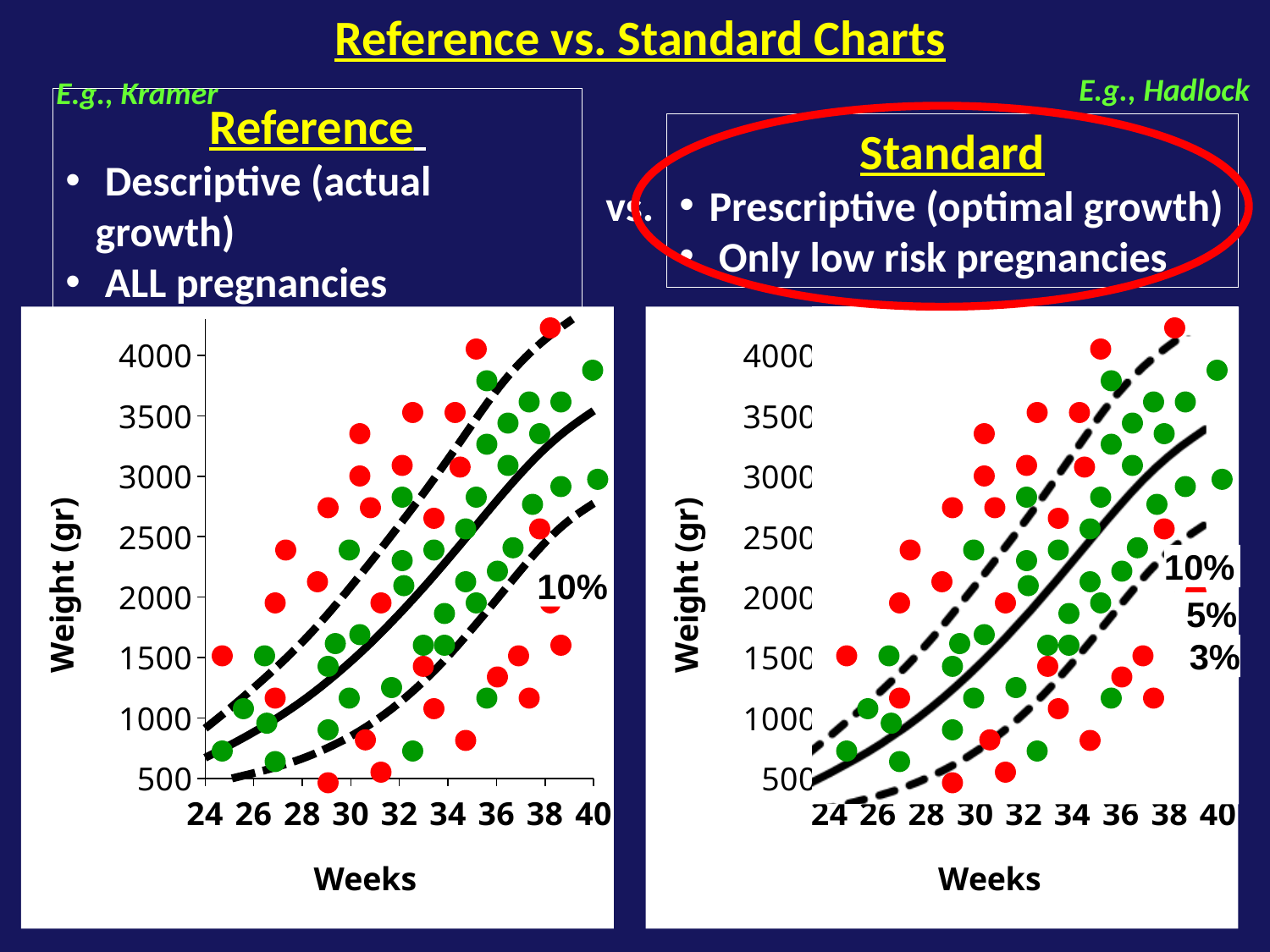
In the left chart, is the solid curve's weight at 24 weeks greater or less than 1000? less What kind of chart is the left chart under 'Reference'? scatter chart Which percentage labels are printed next to the lower curve in the right chart? 10%, 5%, 3% How many week values are labelled on the x axis of the left chart? 9 In the left chart, does the solid growth curve rise or fall as weeks increase from 24 to 40? rise In the right chart, is the solid curve's weight at 28 weeks greater or less than 1500? less In the left chart, is the solid curve's weight at 40 weeks greater or less than 3000? greater In the right chart, does the solid growth curve rise or fall as weeks increase from 24 to 40? rise What kind of chart is the right chart under 'Standard'? scatter chart What is the y-axis title of the left chart? Weight (gr)